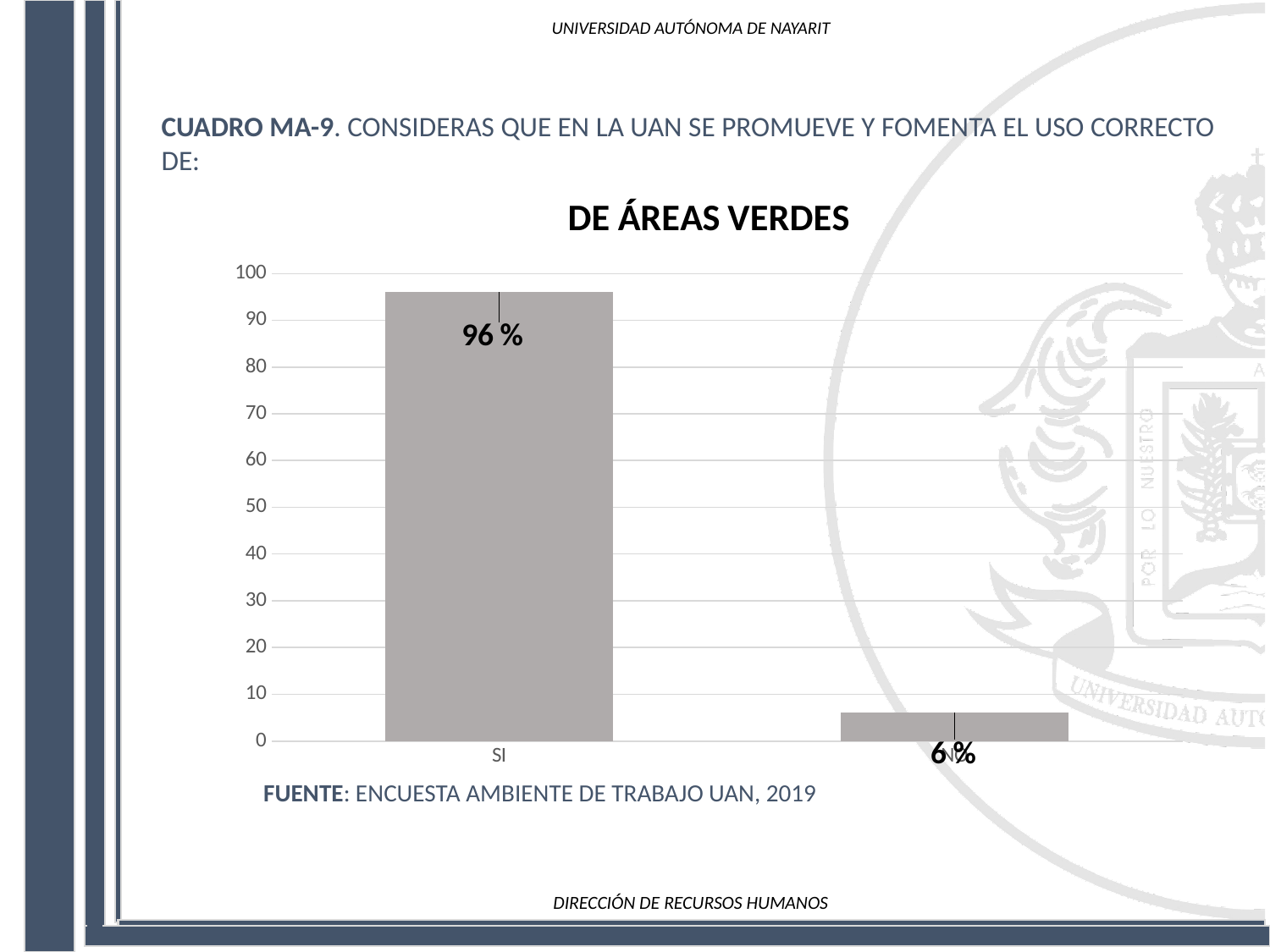
Is the value for SI greater or less than 90? greater What kind of chart is shown on the slide? Bar chart Do the bar values rise or fall from left to right? fall What is the value shown for the SI bar? 96 % Which is larger, the SI bar or the bar on the right? SI What is the title of the chart? DE ÁREAS VERDES Which bar is the highest in the chart? SI What is the value shown on the bar on the right of the chart? 6 % How many bars are plotted in the chart? 2 What is the maximum value shown on the vertical axis? 100 Is the value of the bar on the right greater or less than 10? less What is the difference between the SI bar (96 %) and the right-hand bar (6 %)? 90 %